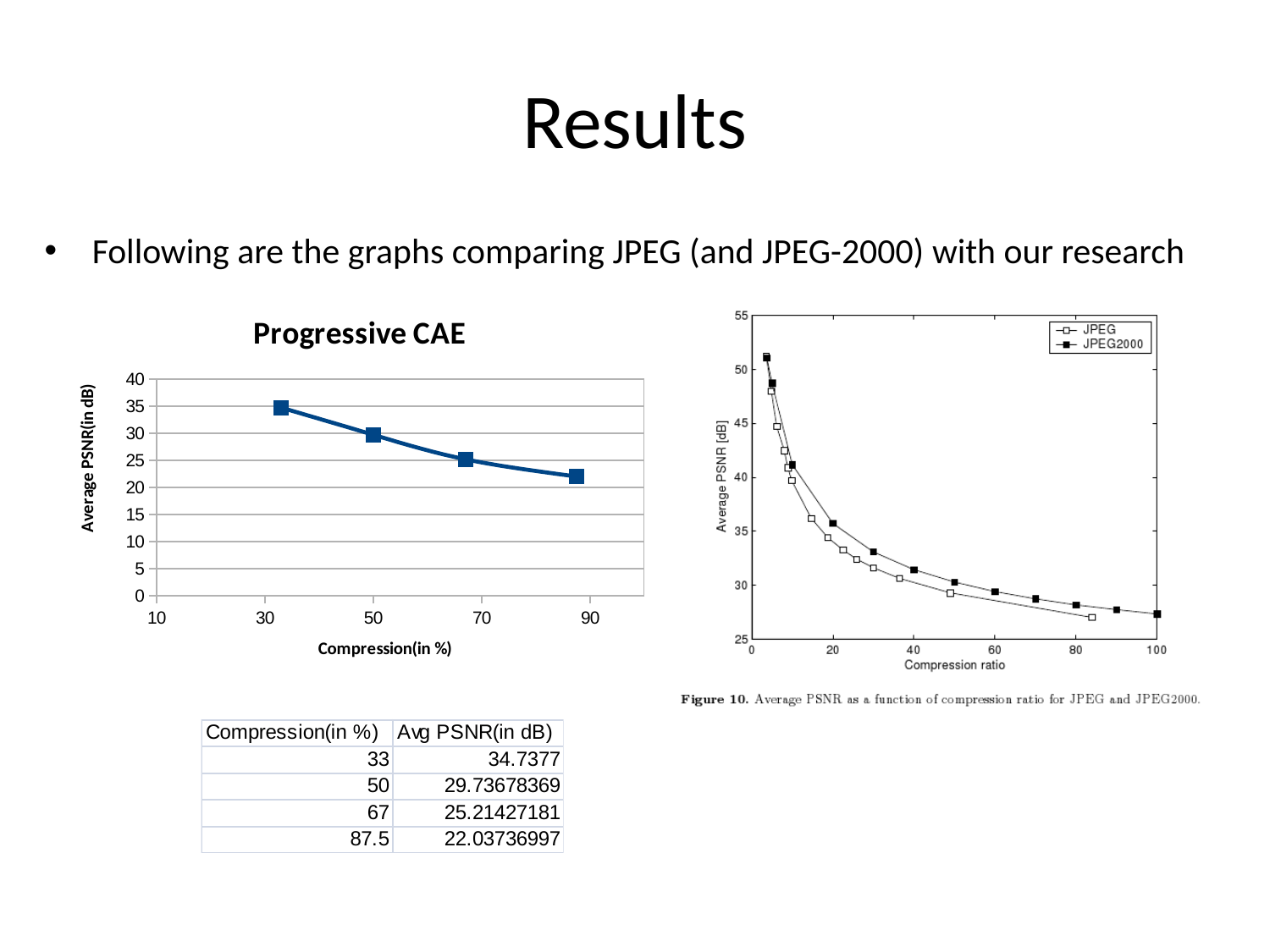
In the Figure 10 chart on the right, which series has the higher Average PSNR at a compression ratio of 20, JPEG or JPEG2000? JPEG2000 In the Progressive CAE chart, is the Average PSNR at 87.5% compression greater or less than 25? less In the Progressive CAE chart, how many data points are plotted? 4 In the Progressive CAE chart, is the Average PSNR at 33% compression greater or less than 30? greater In the Progressive CAE chart, does Average PSNR rise or fall as Compression increases? fall According to the table under the Progressive CAE chart, what is the Avg PSNR at 33% compression? 34.7377 What type of chart is the Progressive CAE chart on the left? line chart According to the table under the Progressive CAE chart, what is the Avg PSNR at 87.5% compression? 22.03736997 In the Progressive CAE chart, at which compression value is the Average PSNR highest? 33 In the Figure 10 chart on the right, is the JPEG2000 Average PSNR at a compression ratio of 100 greater or less than 25? greater What is the x-axis label of the Figure 10 chart on the right? Compression ratio In the Figure 10 chart on the right, how many series does the legend list? 2